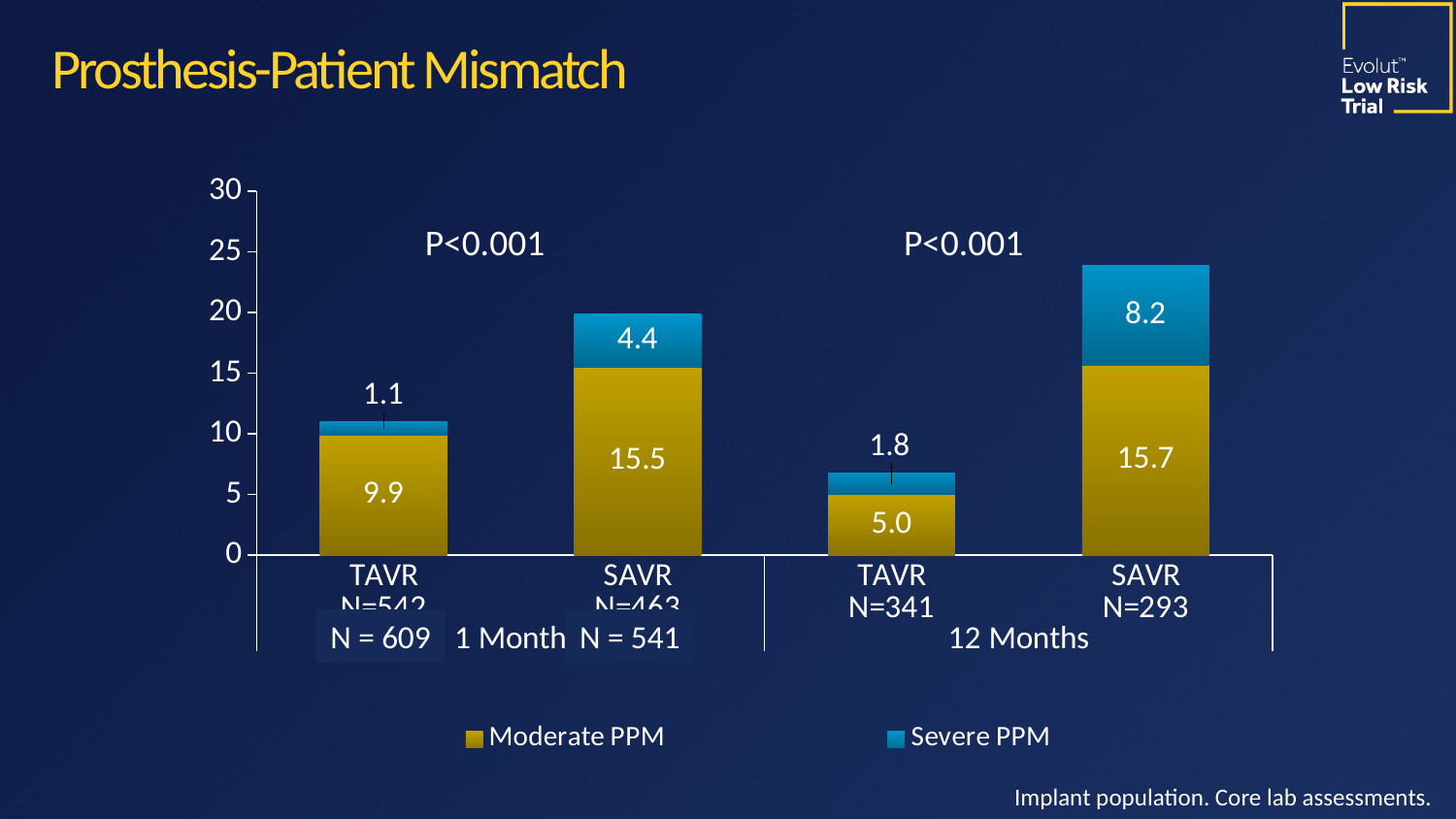
What is the Moderate PPM value for SAVR at 1 Month? 15.5 What is the total stacked value for the TAVR bar at 1 Month? 11.0 What is the Moderate PPM value for TAVR at 1 Month? 9.9 What kind of chart is shown on the slide? Stacked bar chart Which bar has the highest Severe PPM value? SAVR at 12 Months What is the total stacked value for the SAVR bar at 12 Months? 23.9 Is the Severe PPM value larger for SAVR at 1 Month or SAVR at 12 Months? SAVR at 12 Months How many series does the legend list? 2 Which bar has the lowest Moderate PPM value? TAVR at 12 Months What is the Severe PPM value for TAVR at 12 Months? 1.8 What is the Severe PPM value for SAVR at 12 Months? 8.2 What is the difference between the Moderate PPM values for SAVR and TAVR at 12 Months? 10.7